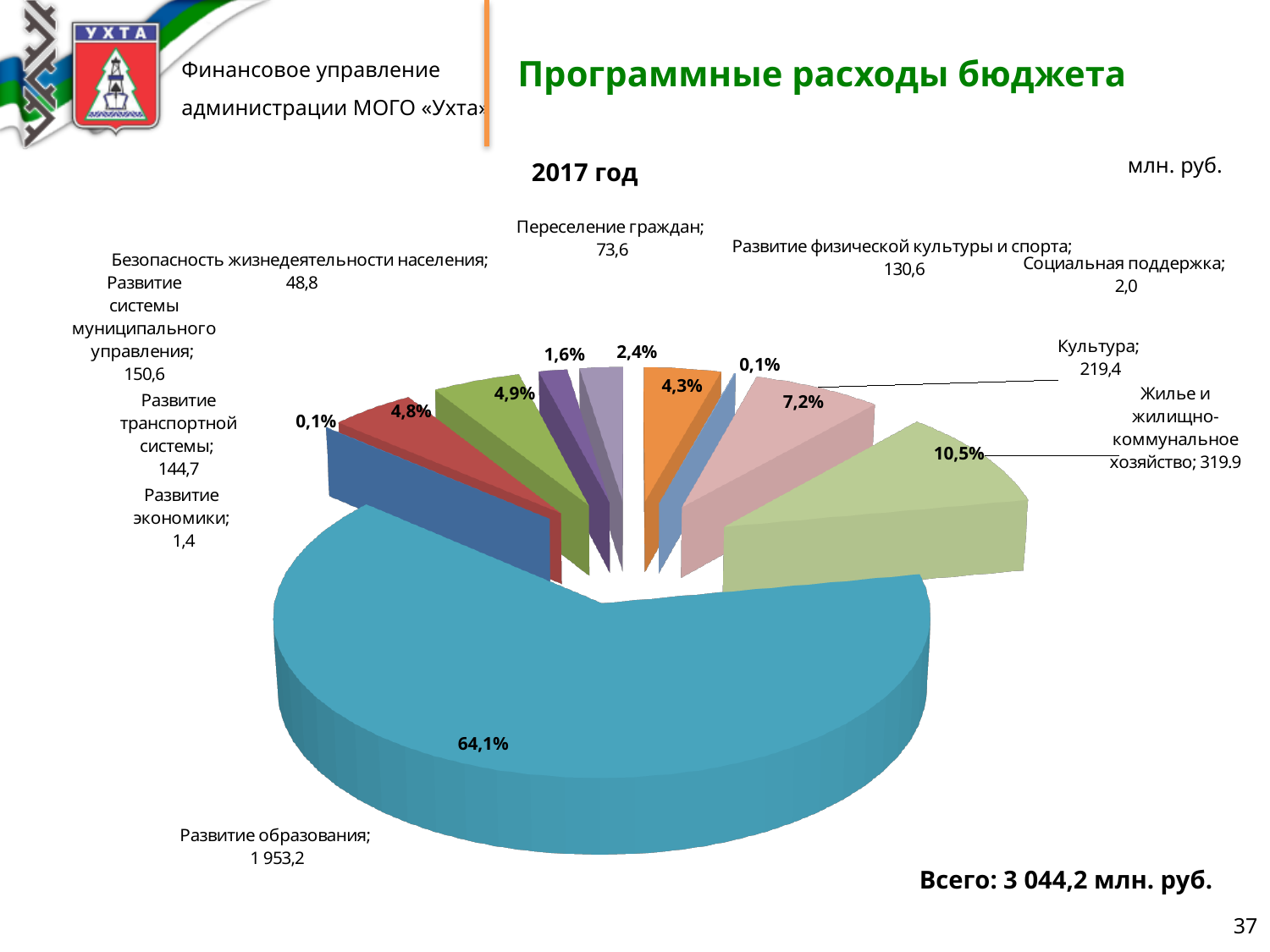
Which category has the lowest value? Развитие экономики What is the value for Развитие образования? 1 953,2 What is the value for Безопасность жизнедеятельности населения? 48,8 Which is larger: Культура or Развитие физической культуры и спорта? Культура Which category has the highest value? Развитие образования What is the value for Культура? 219,4 How many categories are shown in the pie chart? 10 What share of the pie does Развитие образования take? 64,1% What total is stated below the chart? 3 044,2 млн. руб. What is the value for Жилье и жилищно-коммунальное хозяйство? 319.9 What is the difference between Культура and Развитие физической культуры и спорта? 88,8 What kind of chart is shown on the slide? pie chart